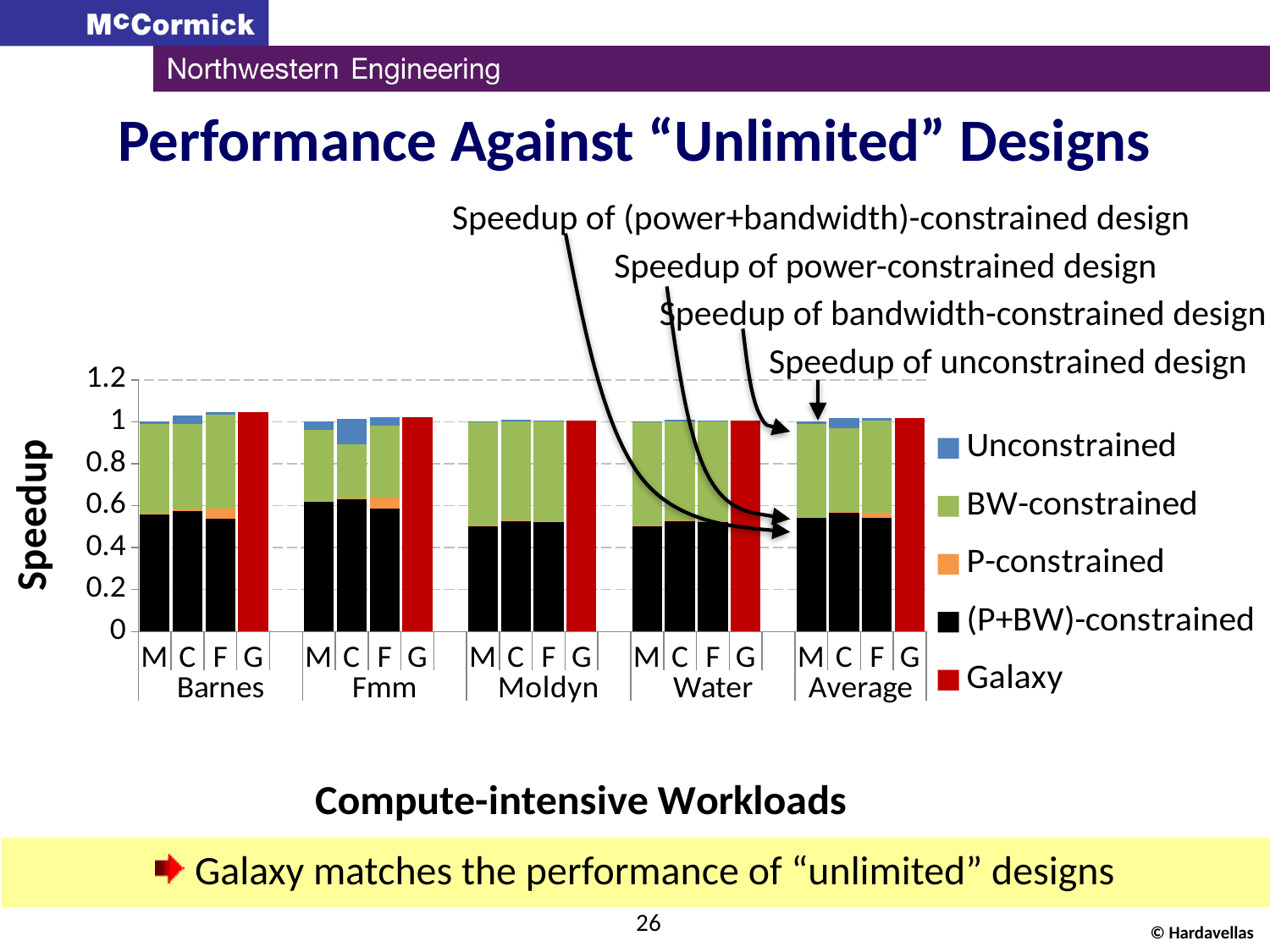
How many workload groups are shown along the x axis of the chart? 5 What kind of chart is shown on the slide? stacked bar chart What is the label of the y axis of the chart? Speedup Which colour represents the Galaxy series in the chart legend? red Is the Galaxy value for Water greater or less than 1.2? less How many series does the chart legend list? 5 Is the Galaxy value for Barnes greater or less than 0.8? greater Which is larger: the (P+BW)-constrained value for the M bar of Fmm or for the M bar of Moldyn? Fmm How many bars (M, C, F, G) are shown within each workload group? 4 Is the (P+BW)-constrained value for the M bar of Moldyn greater or less than 0.6? less In which workload group does the C bar have the largest Unconstrained segment? Fmm